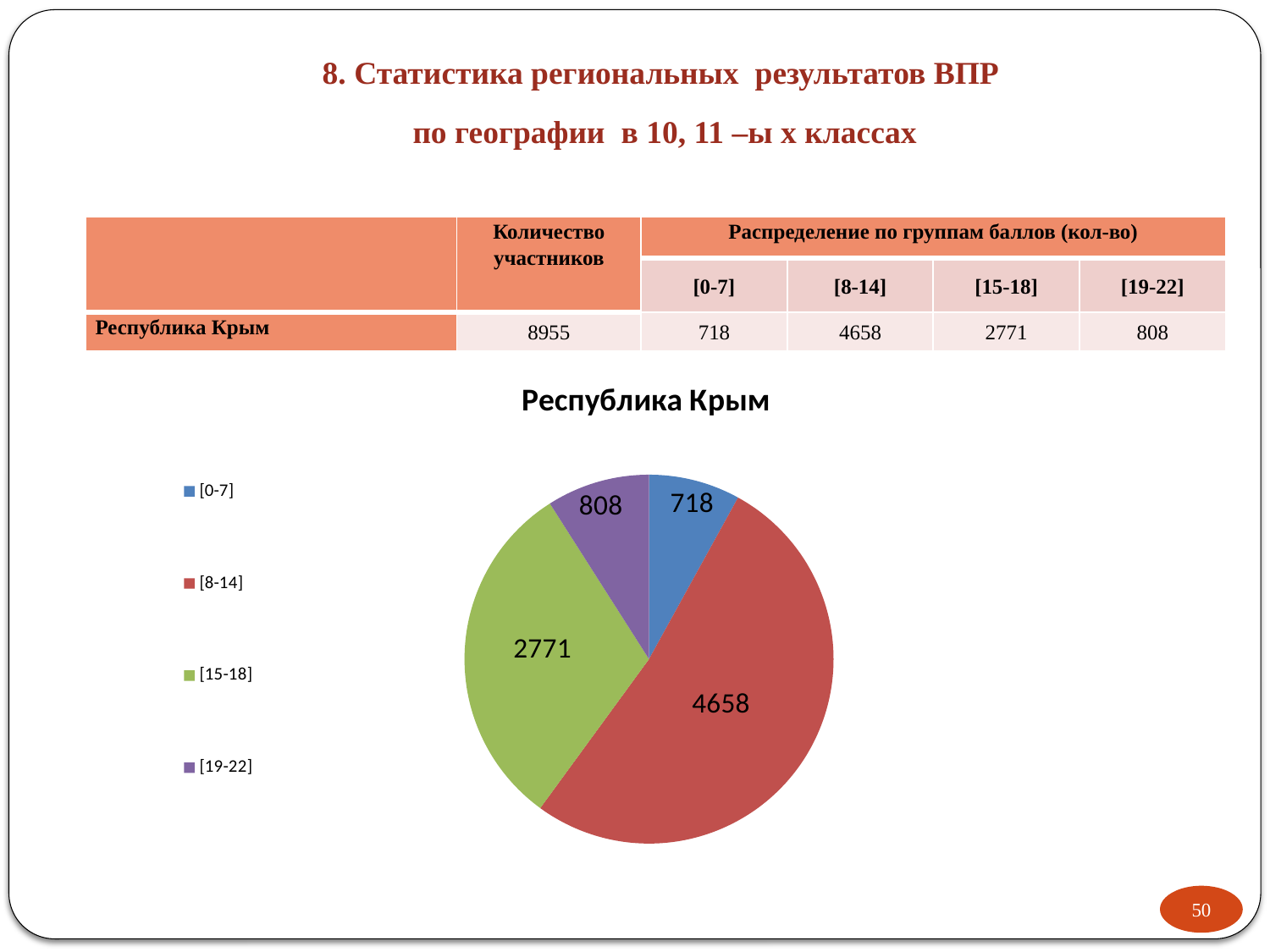
Which slice is larger, [19-22] or [0-7]? [19-22] What is the title of the chart? Республика Крым What is the value of the [15-18] slice in the pie chart? 2771 How many slices does the pie chart have? 4 What colour is the [15-18] slice in the pie chart? green Which score group has the smallest slice in the pie chart? [0-7] What is the value of the [0-7] slice in the pie chart? 718 Which score group has the largest slice in the pie chart? [8-14] What type of chart is shown on the slide? pie chart What is the value of the [8-14] slice in the pie chart? 4658 How many entries does the chart legend list? 4 What is the difference between the [8-14] slice and the [15-18] slice? 1887